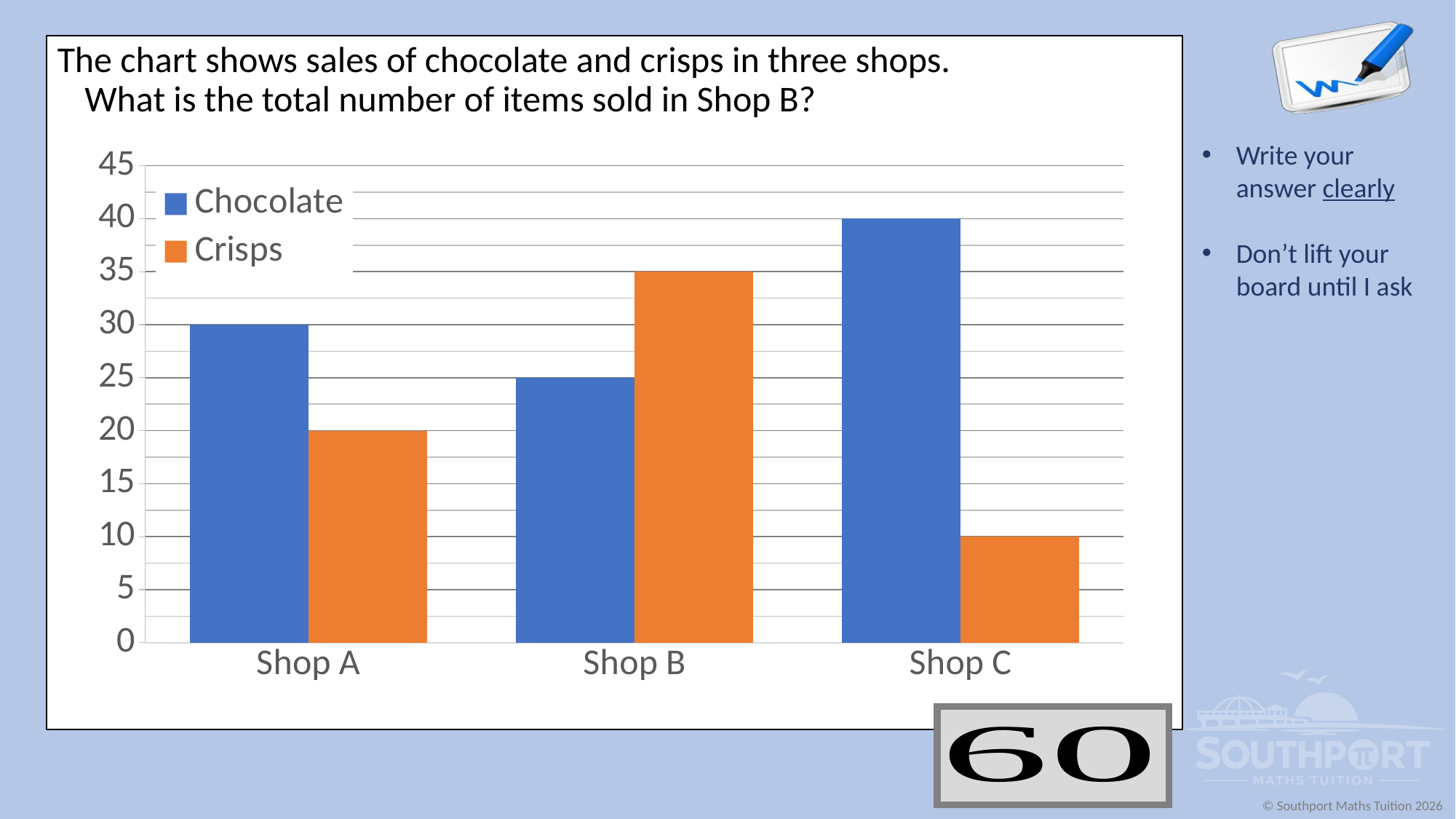
How many shops are shown on the x axis? 3 What colour are the Crisps bars? Orange What is the Crisps value for Shop B? 35 What kind of chart is shown? Bar chart What is the Chocolate value for Shop A? 30 How many series does the legend list? 2 What is the Crisps value for Shop C? 10 Which shop has the highest Chocolate sales? Shop C In Shop B, which is larger, Chocolate or Crisps sales? Crisps Which shop has the lowest Crisps sales? Shop C What is the Chocolate value for Shop C? 40 What is the difference between Chocolate and Crisps sales in Shop A? 10